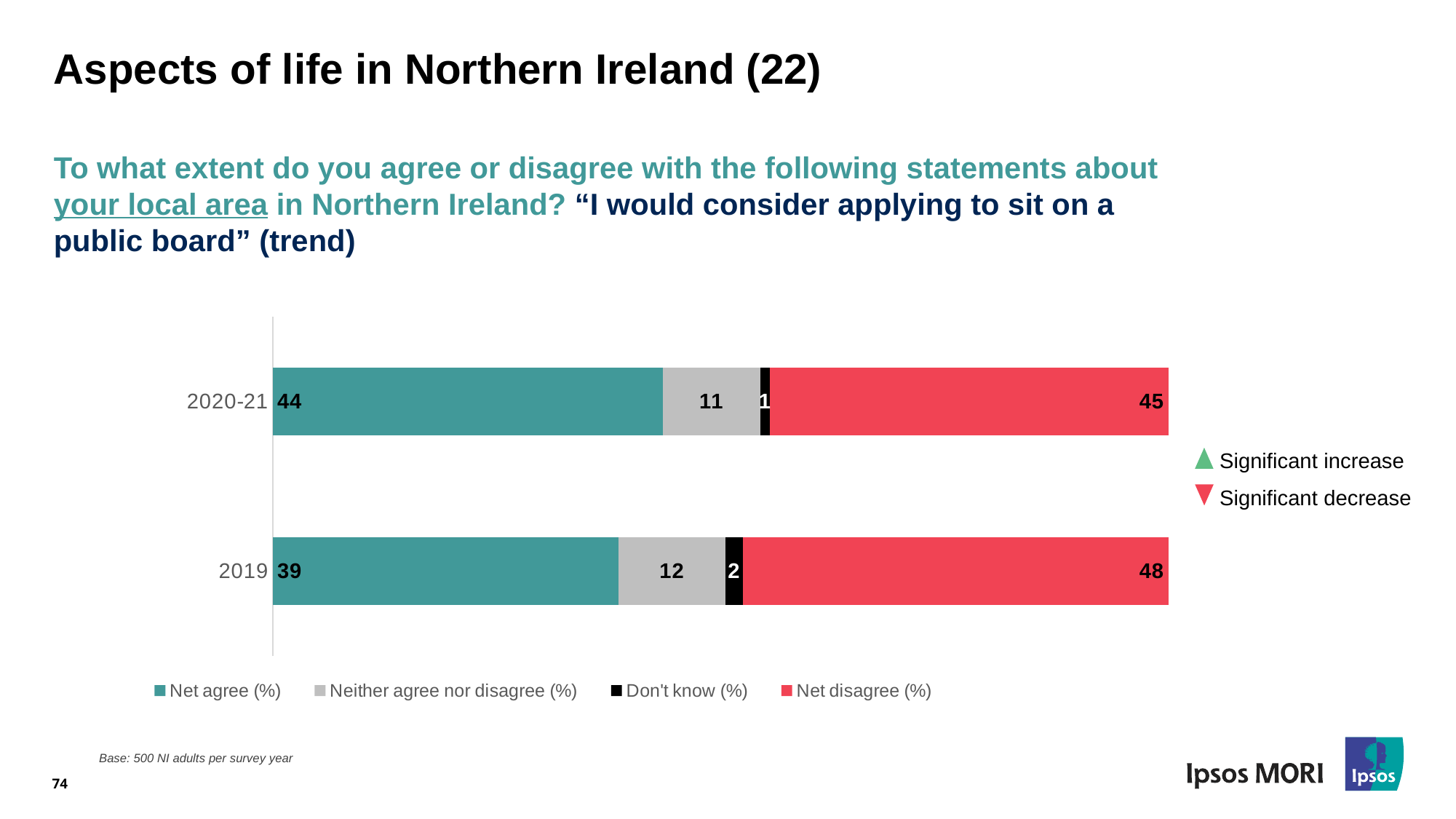
What is the difference between the Net agree (%) values for 2020-21 and 2019? 5 What is the Don't know (%) value for 2019? 2 What is the Net disagree (%) value for 2019? 48 How many categories (years) are shown on the chart? 2 What is the difference between the Net disagree (%) values for 2019 and 2020-21? 3 Which colour represents Net disagree (%) in the chart? Red What kind of chart is shown on the slide? Stacked bar chart What is the Net agree (%) value for 2020-21? 44 What is the total of the stacked bar for 2019? 101 Which year has the higher Net agree (%) value? 2020-21 What is the Neither agree nor disagree (%) value for 2020-21? 11 How many series does the legend list? 4